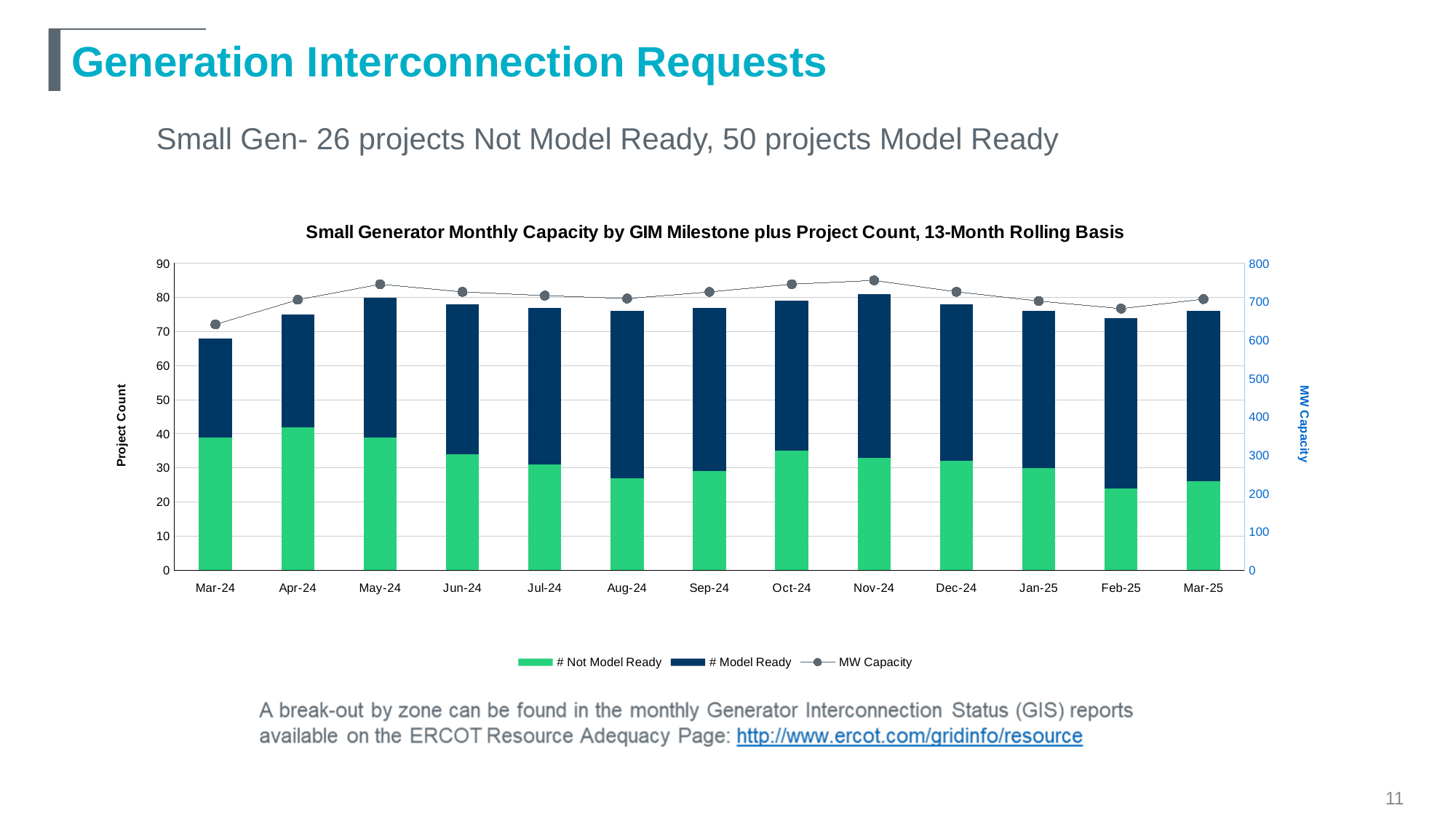
Is the # Not Model Ready value for Feb-25 greater or less than 30? less Which month has the lowest MW Capacity value on the line? Mar-24 Which month has the lowest total project count (stacked bar)? Mar-24 Which is larger, the total project count for Mar-24 or for Apr-24? Apr-24 How many months are shown on the x axis of the chart? 13 Which month has the highest # Not Model Ready value? Apr-24 What kind of chart is shown on the slide? A stacked bar chart combined with a line Is the total project count for Mar-24 greater or less than 70? less What is the label of the right-hand vertical axis? MW Capacity Is the MW Capacity value for Nov-24 greater or less than 700? greater Does the MW Capacity line rise or fall from Mar-24 to May-24? rise How many series does the chart's legend list? 3